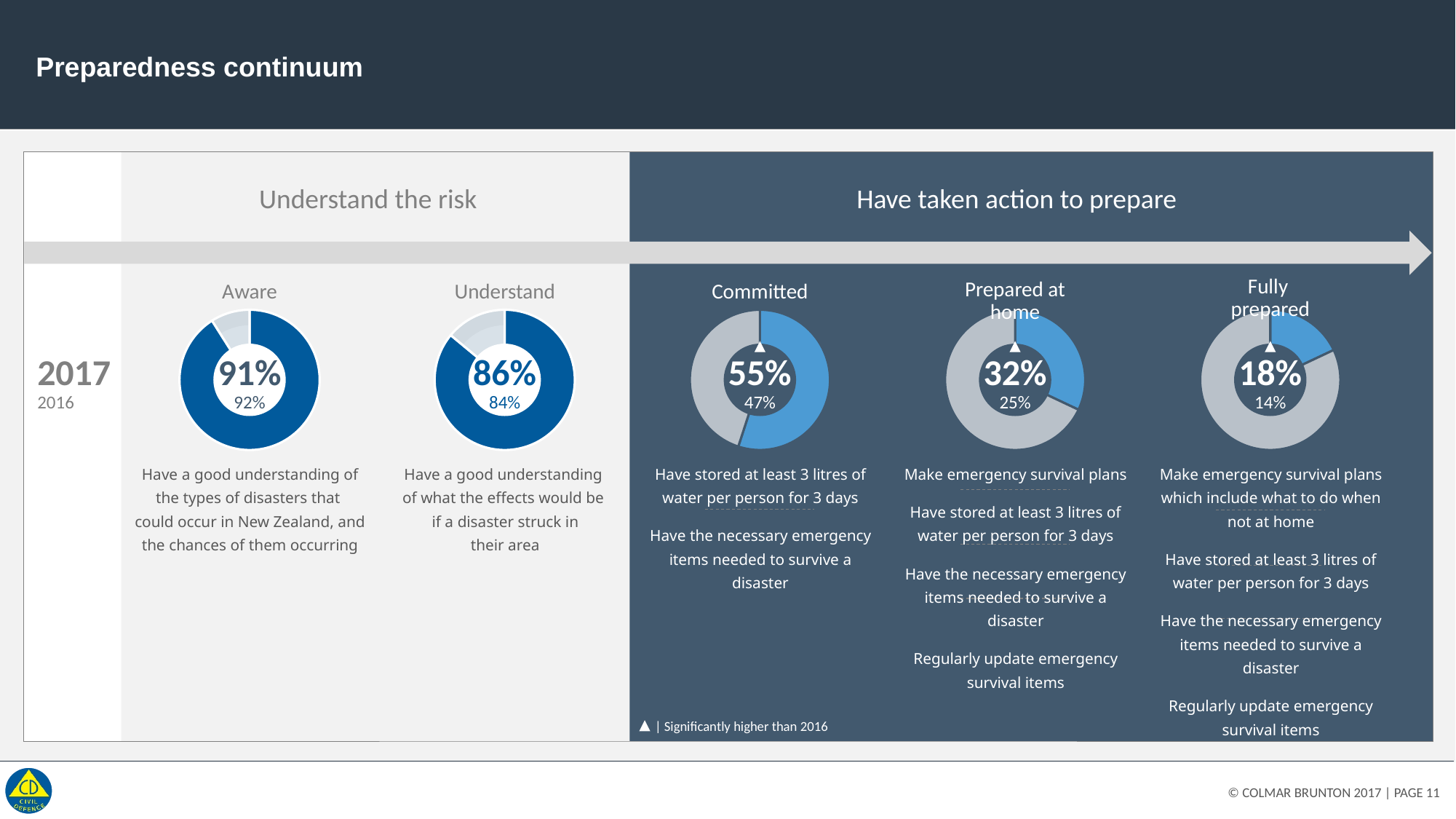
In the Fully prepared donut chart, what is the 2017 value? 18% In the Prepared at home donut chart, what was the 2016 value? 25% How many donut charts are shown on the slide? 5 In the Committed donut chart, what is the 2017 value? 55% Do the 2017 values fall or rise moving from the Aware chart on the left to the Fully prepared chart on the right? Fall Which of the five donut charts shows the highest 2017 value? Aware Which of the five donut charts shows the lowest 2017 value? Fully prepared In the Understand donut chart, what was the 2016 value? 84% What type of chart is used to show the Aware value? Donut (pie) chart In the Committed donut chart, by how many percentage points did the value change from 2016 to 2017? 8 percentage points In the Aware donut chart, what is the 2017 value? 91% Which is larger: the 2017 value in the Prepared at home chart or the 2017 value in the Fully prepared chart? Prepared at home